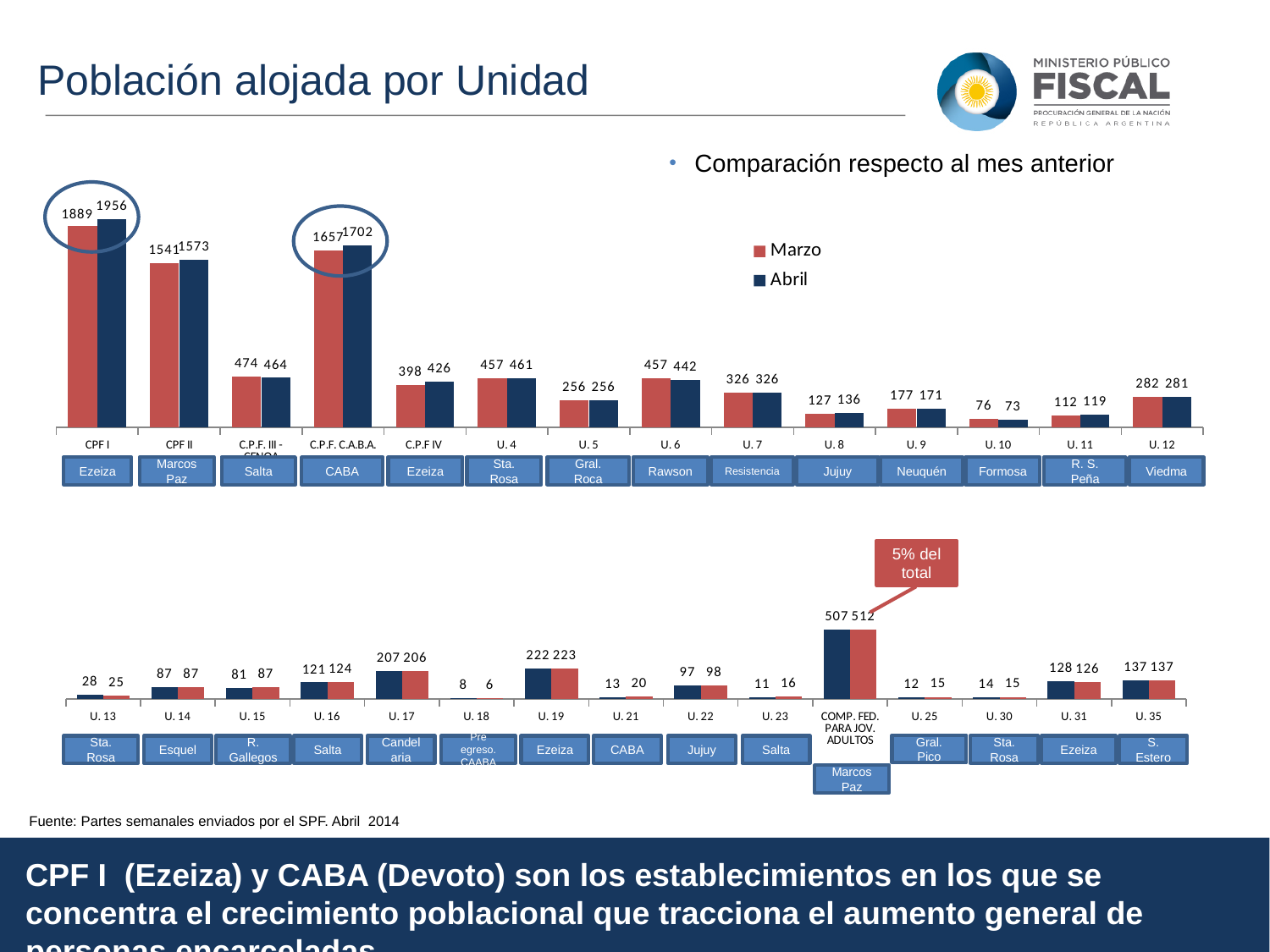
What type of chart is the top chart? Bar chart In the top chart, what is the Marzo value for C.P.F. C.A.B.A.? 1657 How many categories are shown on the x axis of the bottom chart? 15 In the top chart, which is larger for U. 6, the Marzo value or the Abril value? Marzo In the top chart, what is the difference between the Abril and Marzo values for C.P.F. C.A.B.A.? 45 In the top chart, which unit has the lowest Marzo value? U. 10 How many series does the legend of the top chart list? 2 How many units are shown on the x axis of the top chart? 14 In the top chart, which unit has the highest Abril value? CPF I In the top chart, what is the Abril value for CPF I? 1956 In the bottom chart, which category has the highest values? COMP. FED. PARA JOV. ADULTOS In the top chart, what is the difference between the Abril and Marzo values for CPF I? 67